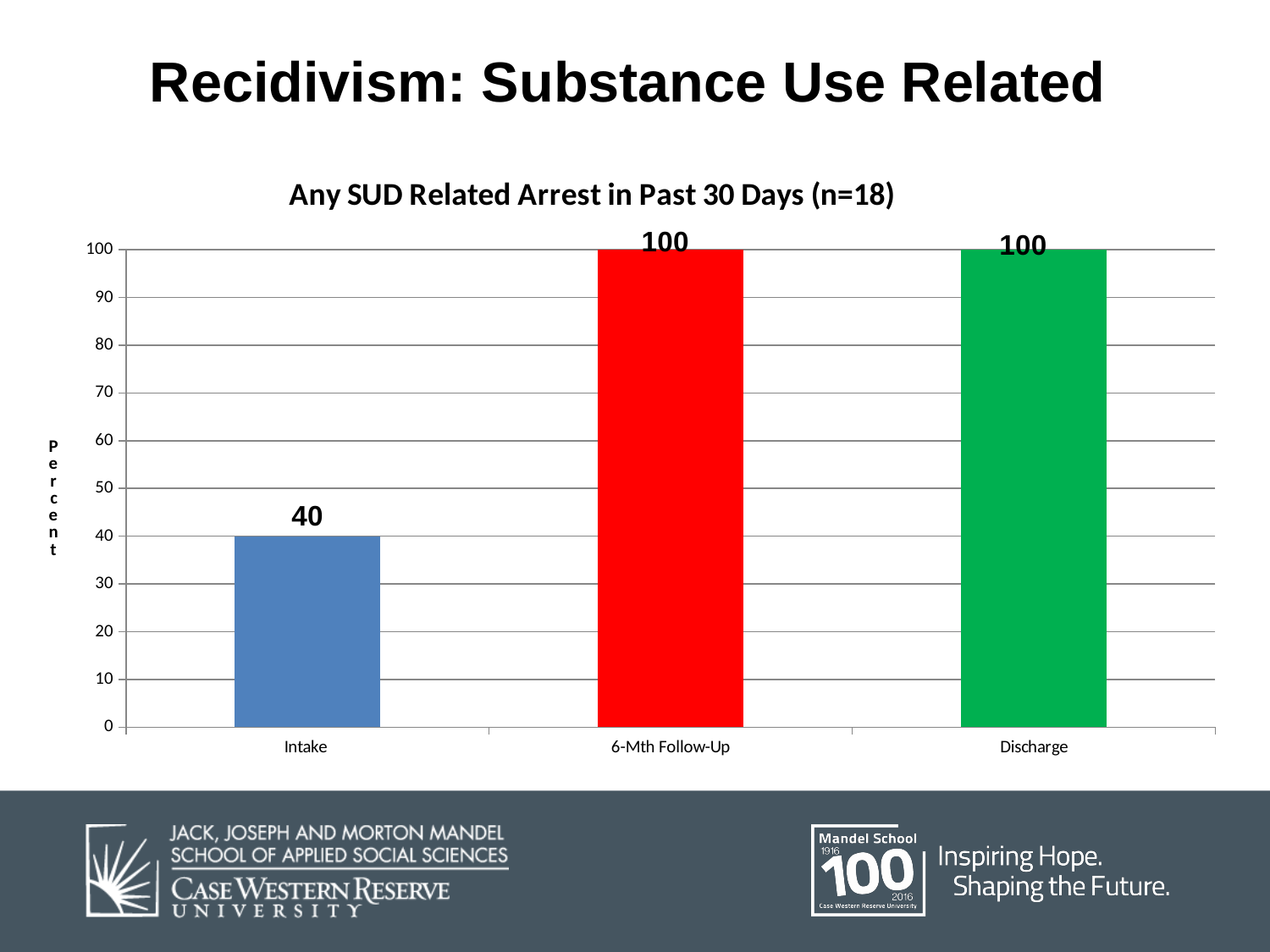
What kind of chart is shown on the slide? bar chart How many categories are shown on the x axis? 3 What colour is the bar for 6-Mth Follow-Up? red What is the title of the chart? Any SUD Related Arrest in Past 30 Days (n=18) What is the difference between the values for 6-Mth Follow-Up and Intake? 60 Is the value for Intake greater or less than 50? less Which category has the lowest value? Intake What is the value for Discharge? 100 Do the values rise or fall from Intake to 6-Mth Follow-Up? rise What is the value for 6-Mth Follow-Up? 100 Which is larger, the value for Intake or the value for Discharge? Discharge What is the value for Intake? 40